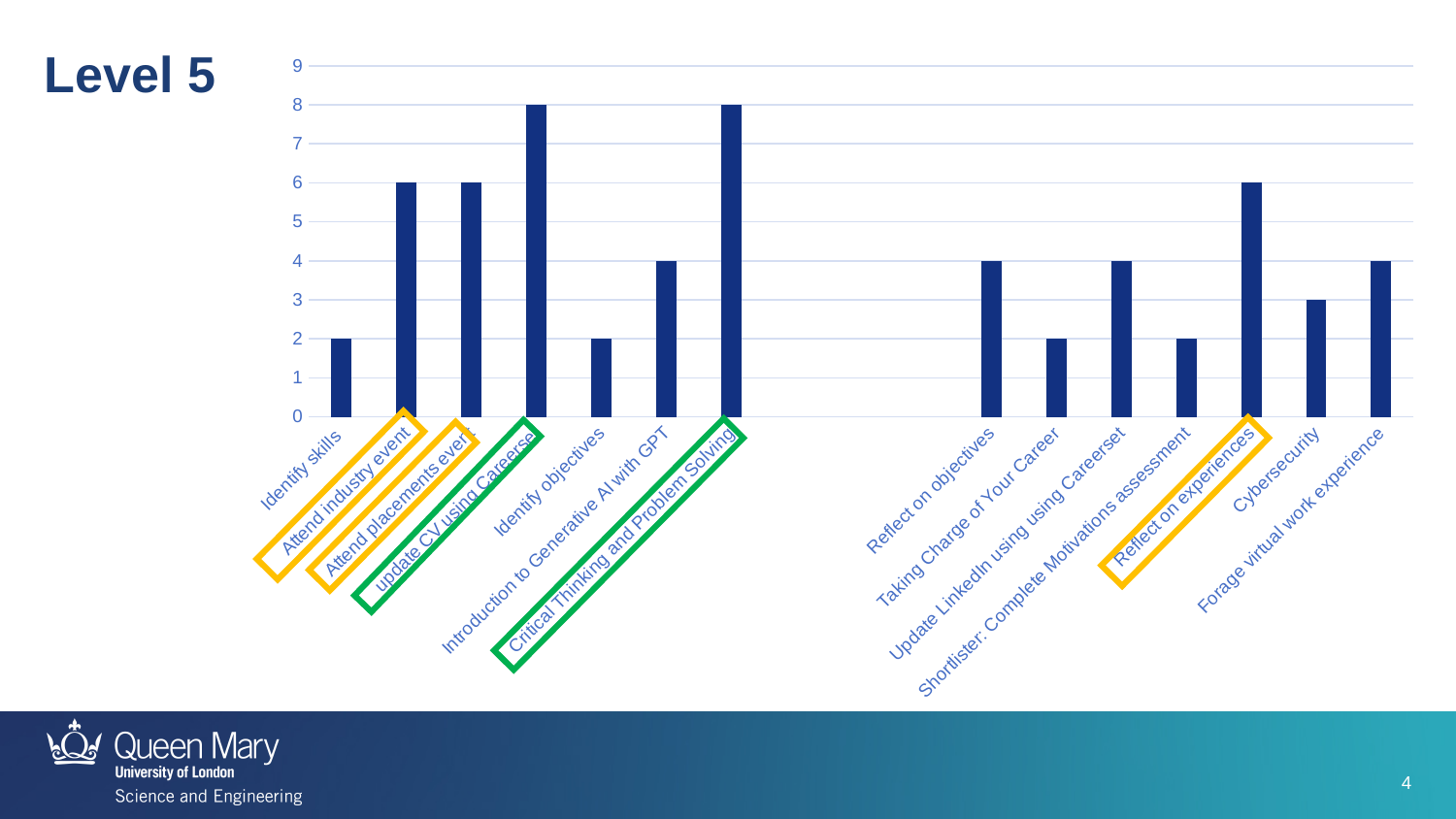
What is the highest value reached by any bar in the chart? 8 Which is larger, the value for Reflect on experiences or the value for Cybersecurity? Reflect on experiences What is the difference between the values for update CV using Careerset and Identify skills? 6 What is the value for Identify skills? 2 What type of chart is shown on the slide? bar chart What is the value for update CV using Careerset? 8 What is the title shown on the slide above the chart? Level 5 What is the value for Introduction to Generative AI with GPT? 4 Is the value for Critical Thinking and Problem Solving greater or less than 5? greater What is the value for Attend industry event? 6 What is the value for Cybersecurity? 3 What is the value for Reflect on experiences? 6